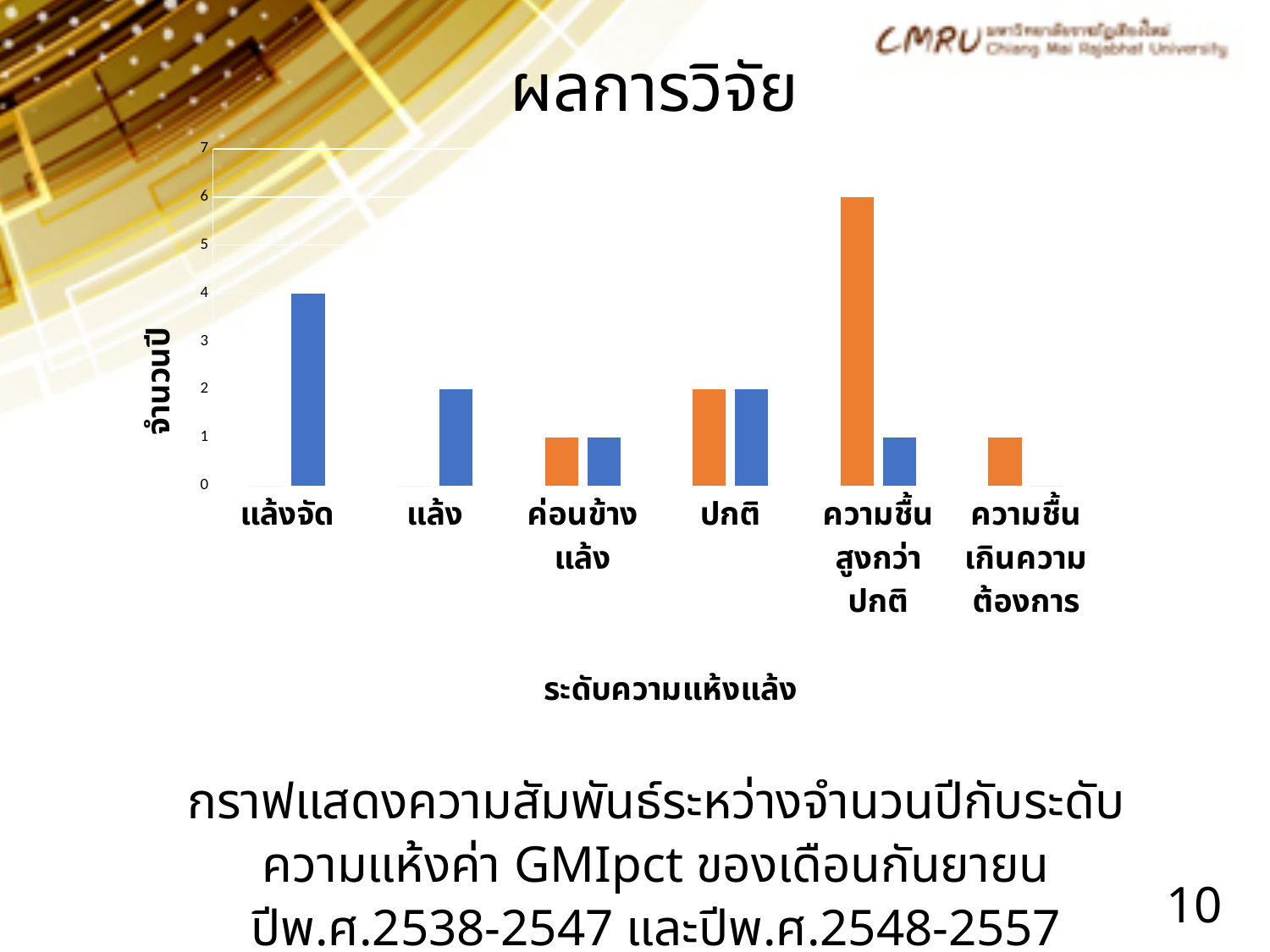
Is the orange bar for ความชื้นสูงกว่าปกติ greater or less than 5? greater What is the difference between the orange bar and the blue bar for ความชื้นสูงกว่าปกติ? 5 What is the label on the vertical axis of the chart? จำนวนปี How many categories are shown on the x axis of the chart? 6 What is the value of the orange bar for ความชื้นสูงกว่าปกติ? 6 Which category has the tallest blue bar? แล้งจัด Which category has the tallest orange bar? ความชื้นสูงกว่าปกติ What kind of chart is shown on the slide? bar chart For ค่อนข้างแล้ง, is the orange bar or the blue bar taller, or are they equal? equal What is the value of the orange bar for ปกติ? 2 What is the value of the blue bar for แล้งจัด? 4 What is the value of the blue bar for แล้ง? 2